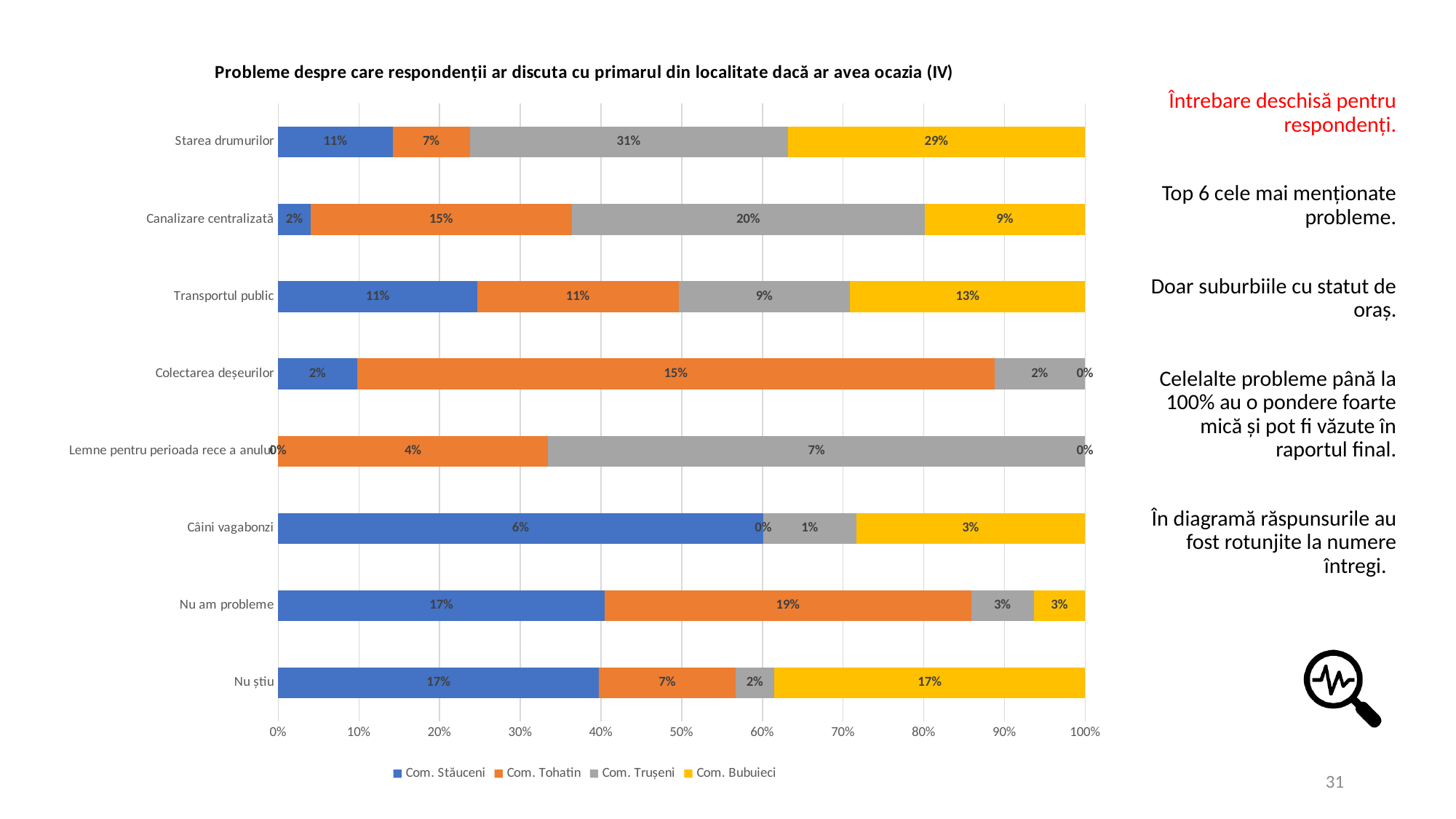
What is the difference between the Com. Bubuieci and Com. Tohatin values for 'Starea drumurilor'? 22% What is the value for Com. Tohatin in the 'Nu am probleme' category? 19% How many problem categories are shown on the chart? 8 In which category does Com. Trușeni have its highest value? Starea drumurilor Which series is shown in orange in the legend? Com. Tohatin What is the value for Com. Trușeni in the 'Starea drumurilor' category? 31% What is the value for Com. Stăuceni in the 'Câini vagabonzi' category? 6% What is the value for Com. Bubuieci in the 'Transportul public' category? 13% In which category does Com. Bubuieci have its highest value? Starea drumurilor What type of chart is shown on the slide? Stacked bar chart How many series does the legend list? 4 For 'Canalizare centralizată', which is larger: the value for Com. Trușeni or for Com. Bubuieci? Com. Trușeni